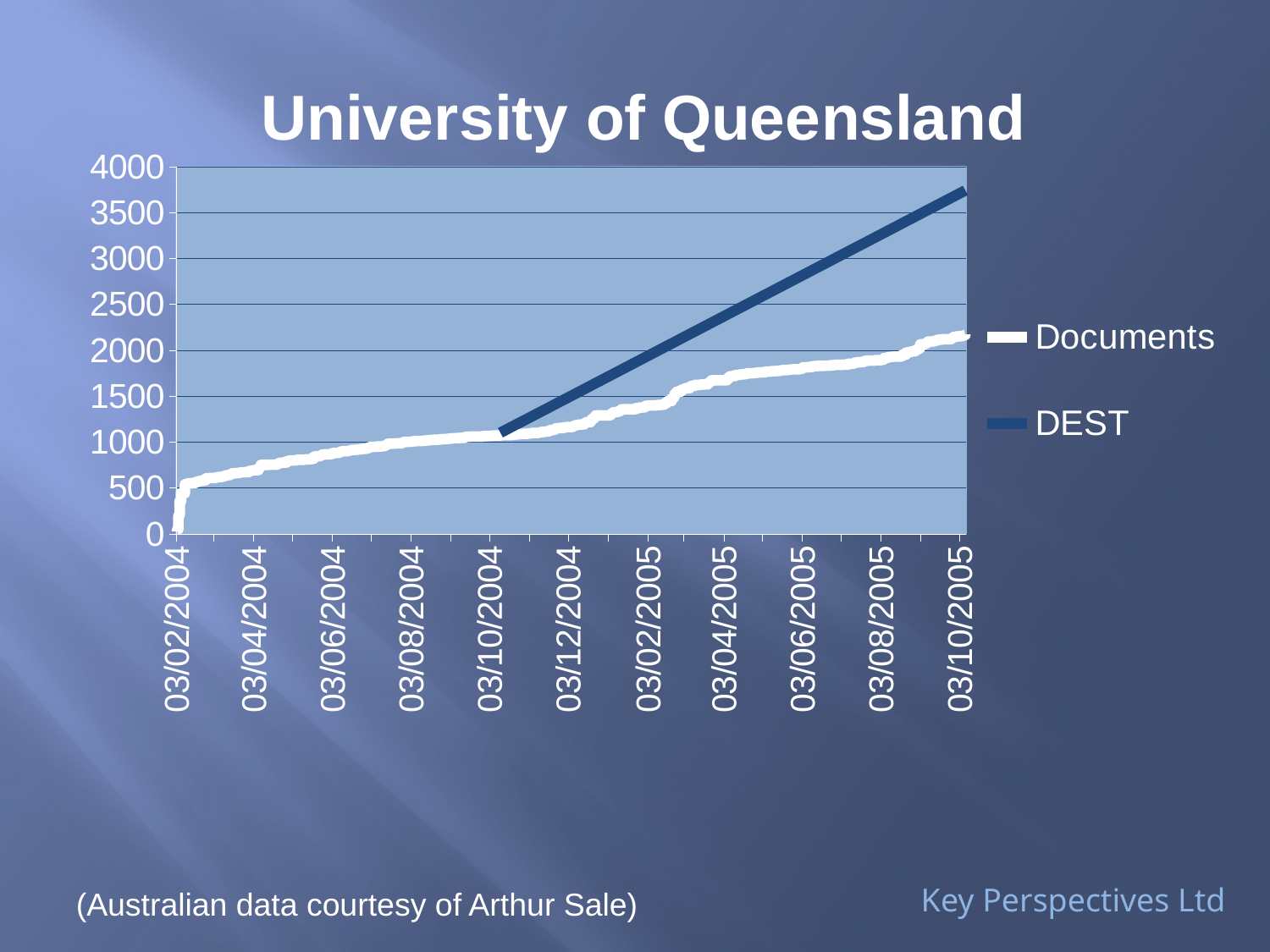
What is the title of the chart? University of Queensland Is the value of the DEST series at 03/10/2005 greater or less than 3500? greater Is the value of the Documents series at 03/06/2004 greater or less than 1000? less How many date labels are shown on the x axis? 11 How many series does the legend list? 2 At 03/10/2005, which series has the higher value, Documents or DEST? DEST What are the two series named in the legend? Documents and DEST Does the DEST series rise or fall from 03/10/2004 to 03/10/2005? rise Does the Documents series rise or fall over time along the x axis? rise What kind of chart is shown on the slide? line chart Is the value of the Documents series at 03/10/2005 greater or less than 2000? greater